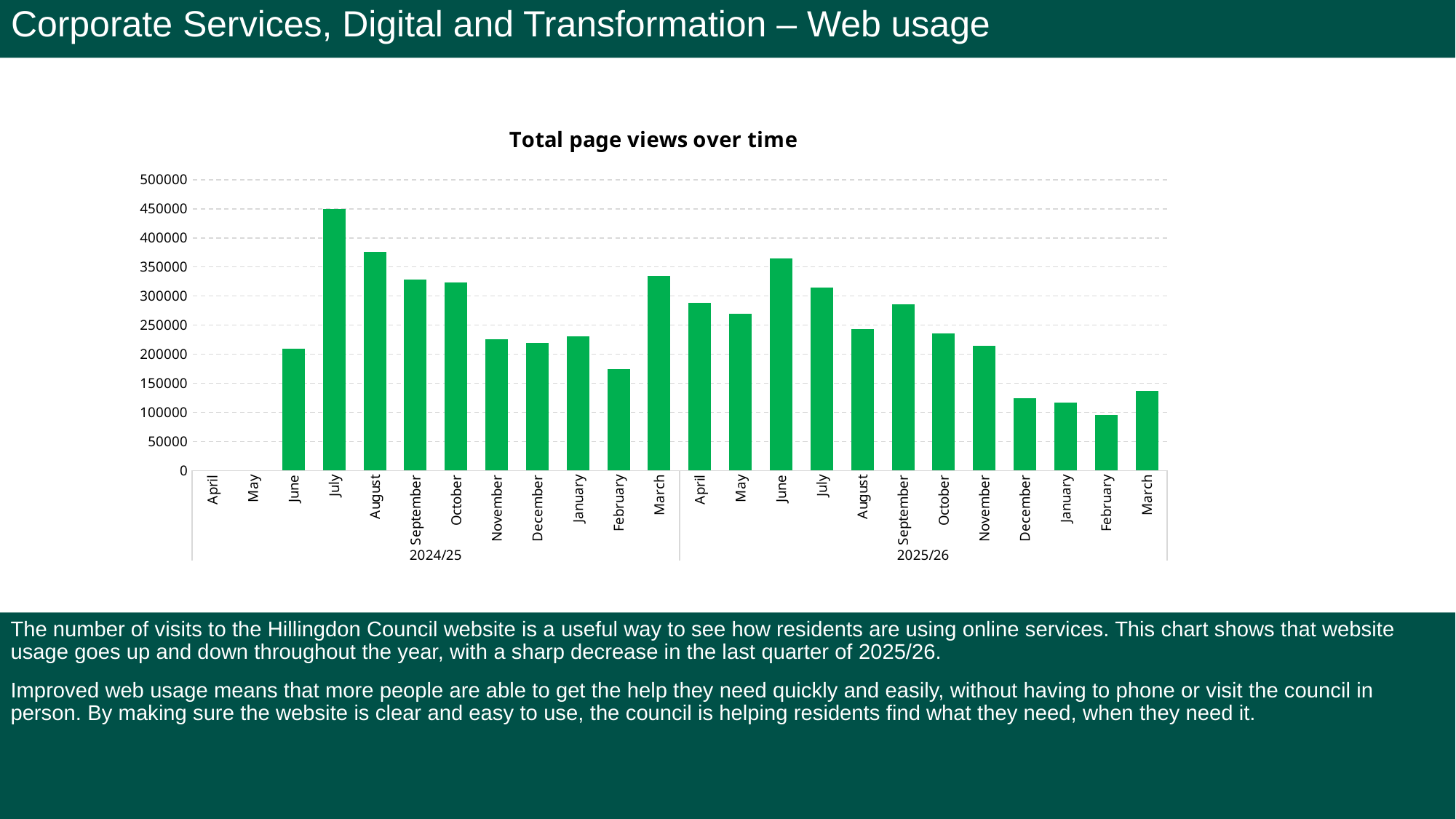
Which month has the lowest total page views across the whole chart? February 2025/26 Which is larger, the value for March 2024/25 or the value for March 2025/26? March 2024/25 Is the value for June 2025/26 greater or less than 350000? greater Is the value for February 2024/25 greater or less than 200000? less How many financial years are shown along the x axis? 2 Which is larger, the value for July 2024/25 or the value for June 2025/26? July 2024/25 Do the values rise or fall from November 2025/26 to February 2025/26? fall What kind of chart is shown on the slide? bar chart What is the title of the chart? Total page views over time Which month has the highest total page views across the whole chart? July 2024/25 Is the value for July 2024/25 greater or less than 400000? greater